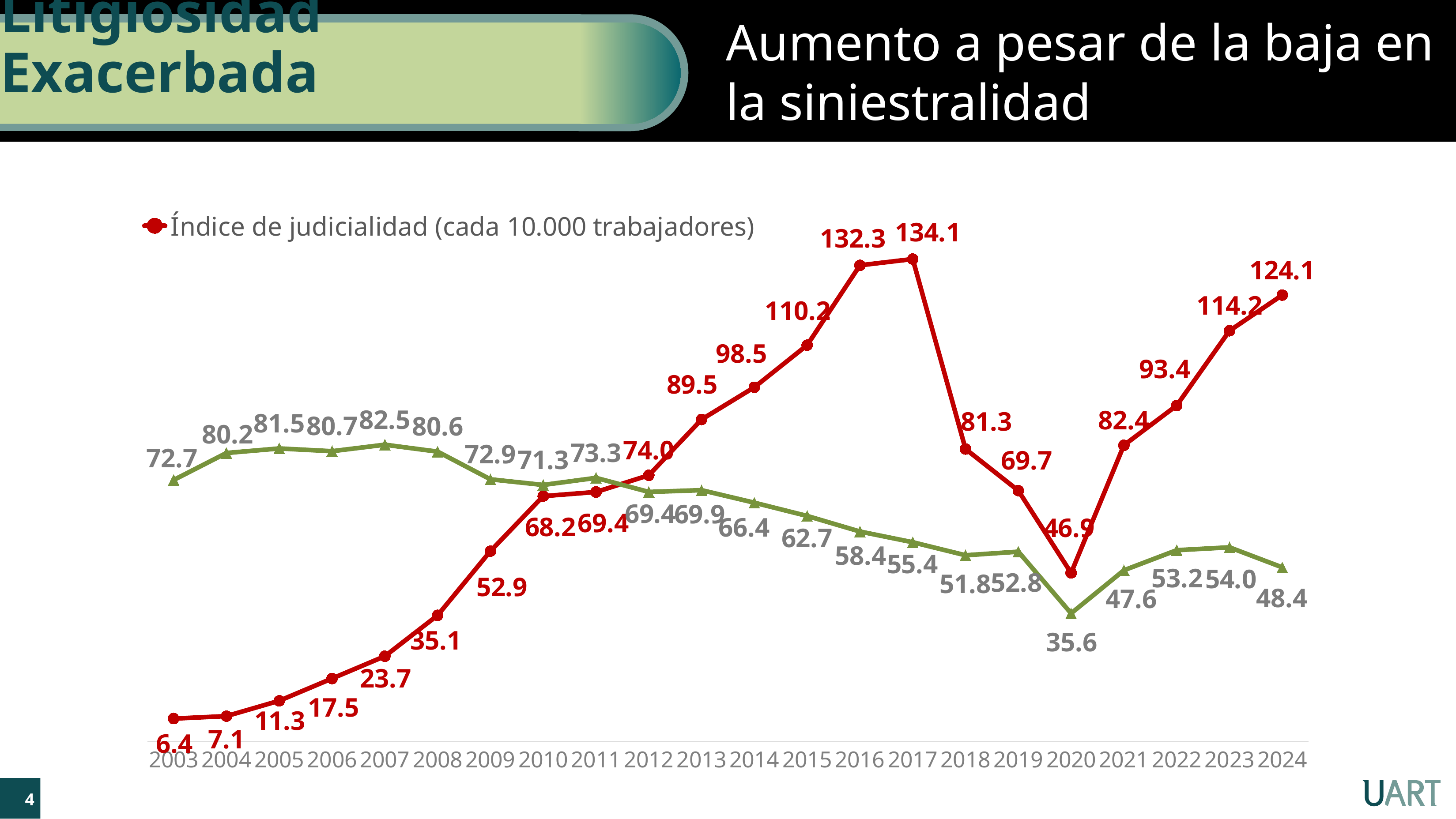
Which year has a higher Índice de judicialidad, 2016 or 2023? 2016 What is the Índice de judicialidad value for 2003? 6.4 In which year is the Índice de judicialidad lowest? 2003 In which year is the Índice de judicialidad highest? 2017 What kind of chart is shown on the slide? Line chart What is the Índice de judicialidad value for 2020? 46.9 How many years are shown on the x axis of the chart? 22 What is the Índice de judicialidad value for 2024? 124.1 What is the difference between the Índice de judicialidad in 2017 and in 2024? 10.0 Does the Índice de judicialidad rise or fall from 2003 to 2017? Rise What is the Índice de judicialidad (cada 10.000 trabajadores) value for 2017? 134.1 What series name does the legend show for the red line? Índice de judicialidad (cada 10.000 trabajadores)